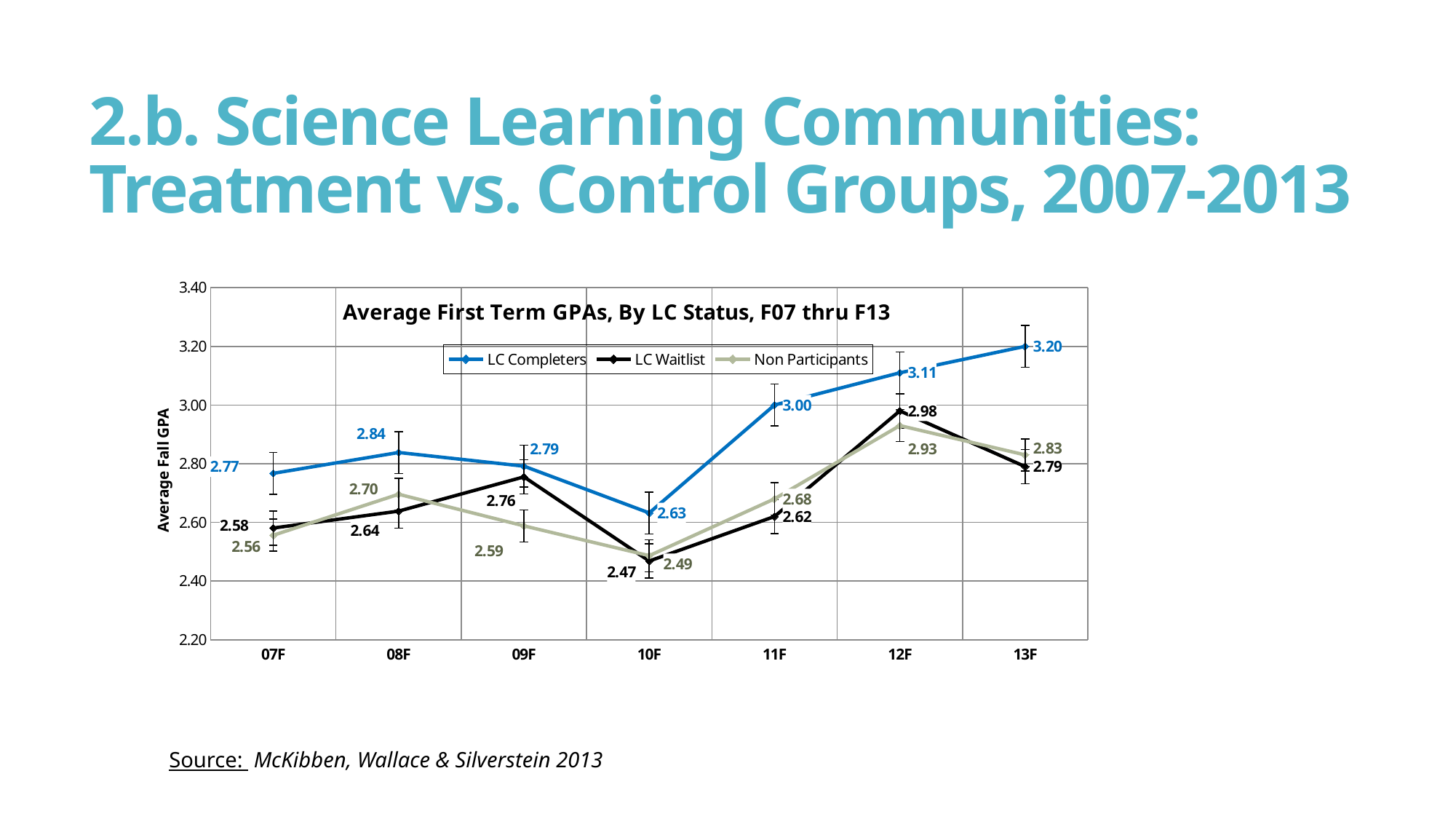
What is the title of the chart? Average First Term GPAs, By LC Status, F07 thru F13 In which term is the LC Waitlist GPA lowest? 10F Which group has the higher GPA in 09F, LC Waitlist or Non Participants? LC Waitlist What kind of chart is shown on the slide? Line chart How many terms are shown on the x axis? 7 In which term is the LC Completers GPA highest? 13F Is the LC Completers GPA in 11F greater or less than 2.80? greater What is the average fall GPA for LC Waitlist in 10F? 2.47 What is the average fall GPA for LC Completers in 13F? 3.20 How many series does the legend list? 3 What is the average fall GPA for Non Participants in 12F? 2.93 What is the difference between the LC Completers and LC Waitlist GPAs in 13F? 0.41